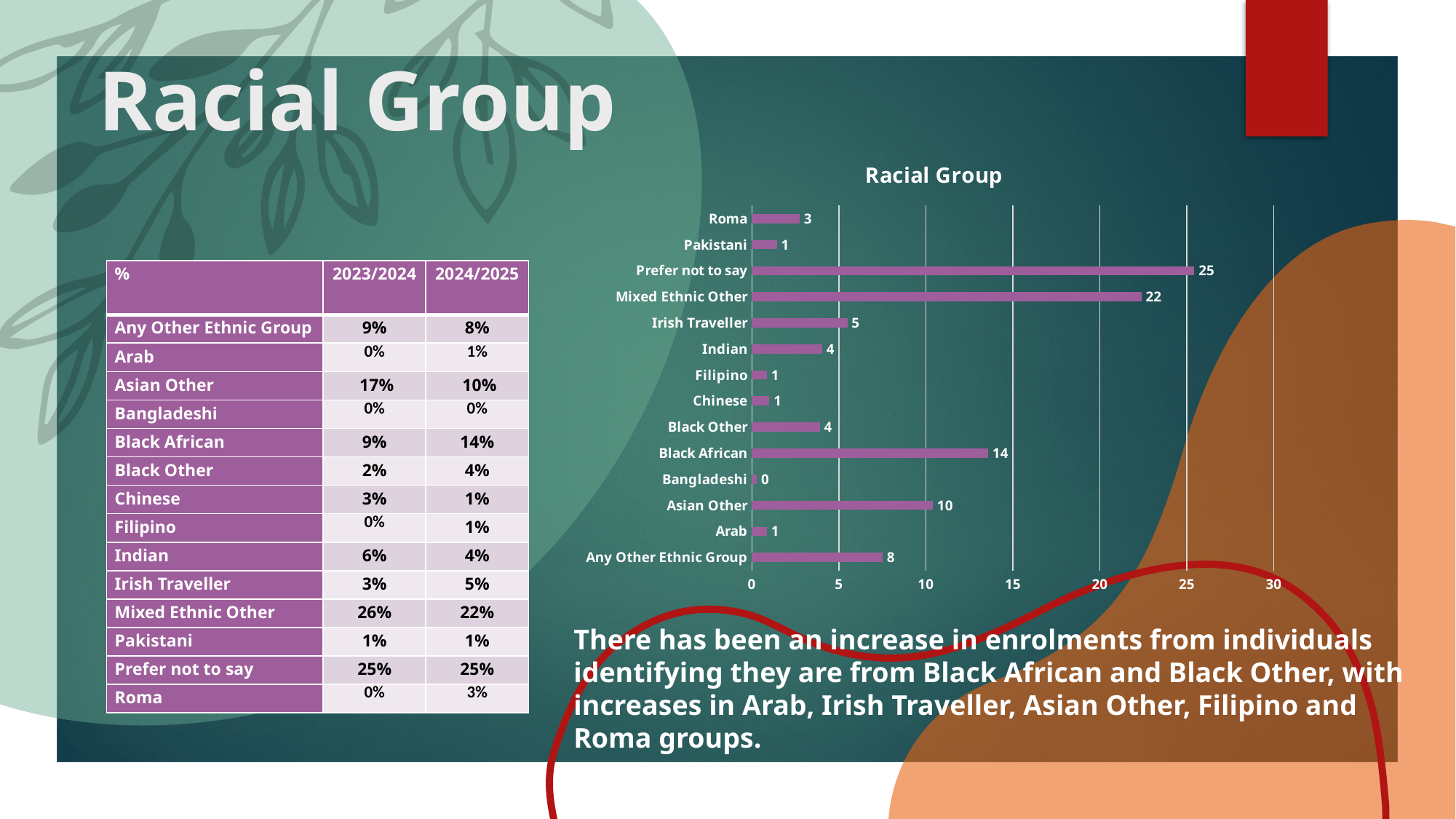
What is the value for Mixed Ethnic Other in the chart? 22 What is the difference between the values for Black African and Black Other? 10 Is the value for Black African greater or less than 10? greater Which is larger in the chart, Asian Other or Irish Traveller? Asian Other Which category has the highest value in the chart? Prefer not to say What is the difference between the values for Prefer not to say and Mixed Ethnic Other? 3 How many categories are plotted in the chart? 14 What is the value for Black African in the chart? 14 What is the title of the chart? Racial Group Which category has the lowest value in the chart? Bangladeshi What type of chart is shown on the slide? Bar chart What is the value for Any Other Ethnic Group in the chart? 8